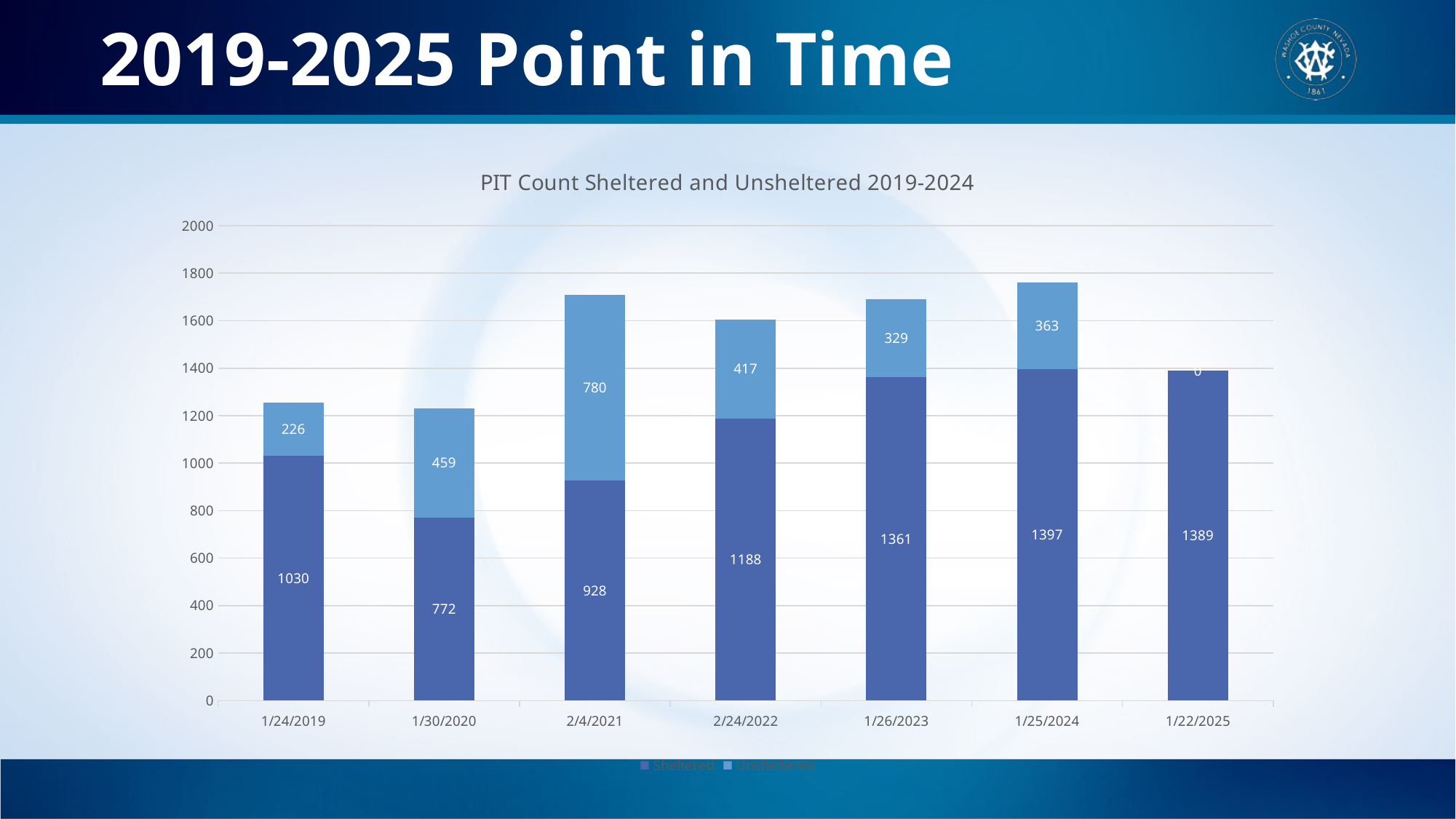
How many dates are shown on the x axis? 7 What is the difference between the Sheltered values for 1/25/2024 and 1/30/2020? 625 Which is larger, the Unsheltered value for 1/30/2020 or for 2/24/2022? 1/30/2020 Which date has the lowest Sheltered value? 1/30/2020 How many series does the legend list? 2 Which date has the highest Unsheltered value? 2/4/2021 What is the total of the stacked bar for 1/25/2024? 1760 What kind of chart is shown on the slide? Stacked bar chart What is the Sheltered value for 1/24/2019? 1030 What is the Unsheltered value for 2/4/2021? 780 What is the Sheltered value for 1/22/2025? 1389 What is the total of the stacked bar for 2/4/2021? 1708